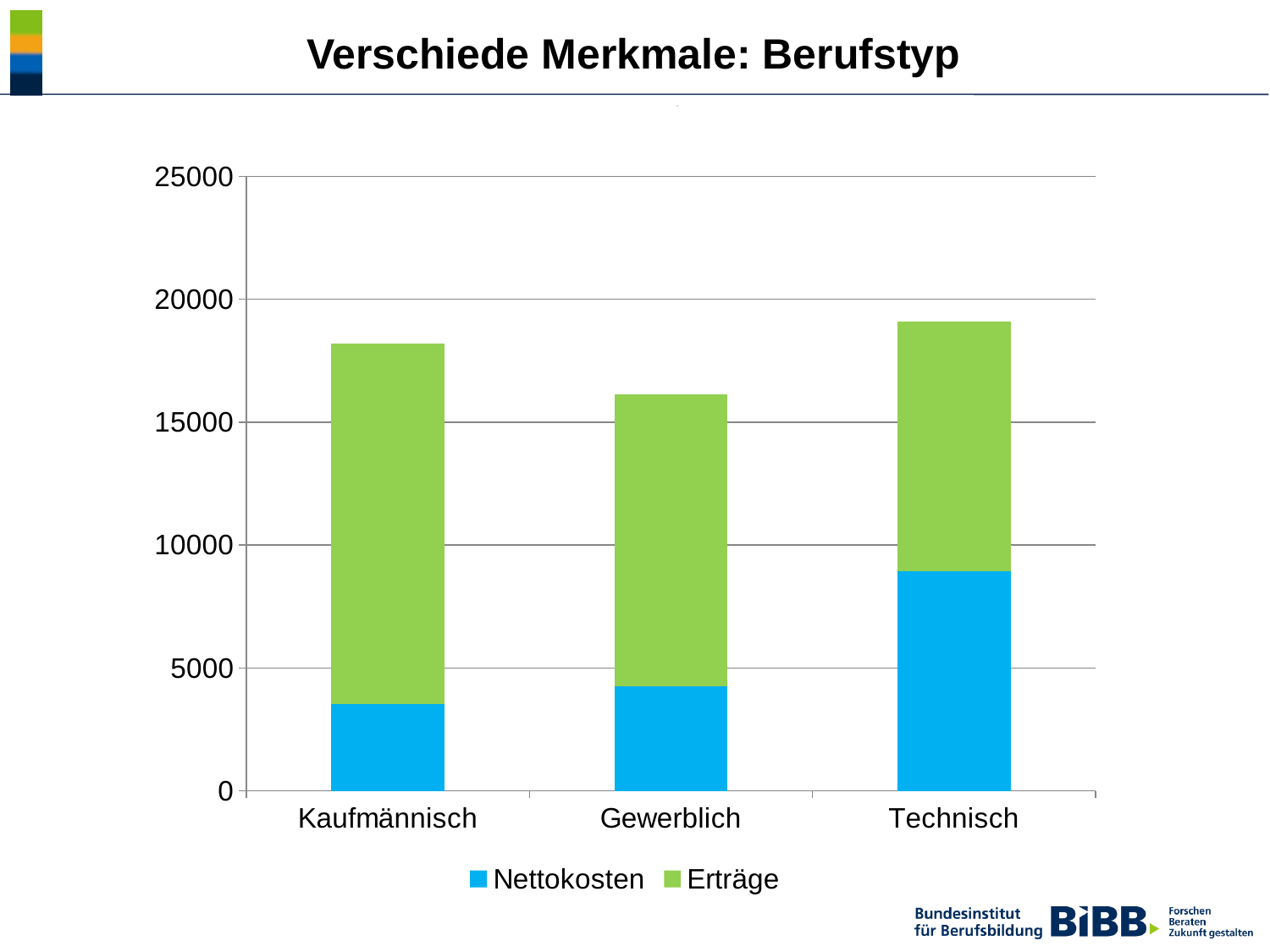
Which series is shown in green in the legend? Erträge What kind of chart is shown on the slide? stacked bar chart How many series does the legend list? 2 How many categories are shown on the x axis? 3 Is the Nettokosten value for Kaufmännisch greater or less than 5000? less Is the Nettokosten value for Technisch greater or less than 10000? less Which category has the highest Nettokosten value? Technisch Is the total stacked bar for Gewerblich greater or less than 15000? greater Which category has the lowest total stacked bar? Gewerblich Which has the larger total stacked bar, Technisch or Gewerblich? Technisch